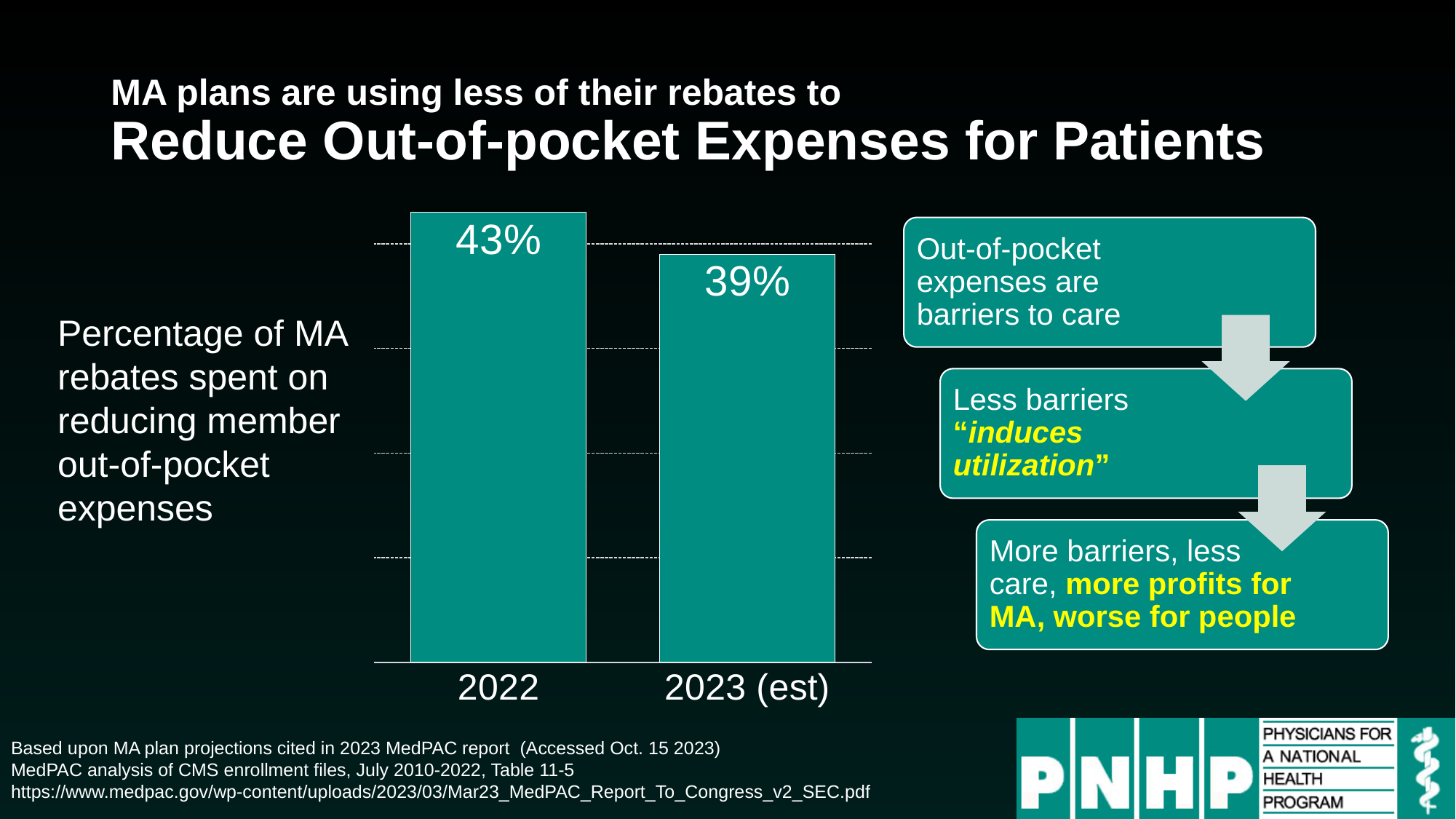
Do the values rise or fall from 2022 to 2023 (est)? fall Is the value for 2022 larger or smaller than the value for 2023 (est)? larger How many bars are shown in the chart? 2 What percentage of MA rebates is estimated to be spent on reducing member out-of-pocket expenses in 2023? 39% What does the chart measure, according to the label to its left? Percentage of MA rebates spent on reducing member out-of-pocket expenses What are the two category labels on the x axis of the chart? 2022 and 2023 (est) Which year has the higher percentage of MA rebates spent on reducing out-of-pocket expenses? 2022 What percentage of MA rebates was spent on reducing member out-of-pocket expenses in 2022? 43% Which year has the lower percentage of MA rebates spent on reducing out-of-pocket expenses? 2023 (est) By how many percentage points did the share of MA rebates spent on reducing out-of-pocket expenses fall from 2022 to 2023 (est)? 4 percentage points What kind of chart is shown on the slide? bar chart